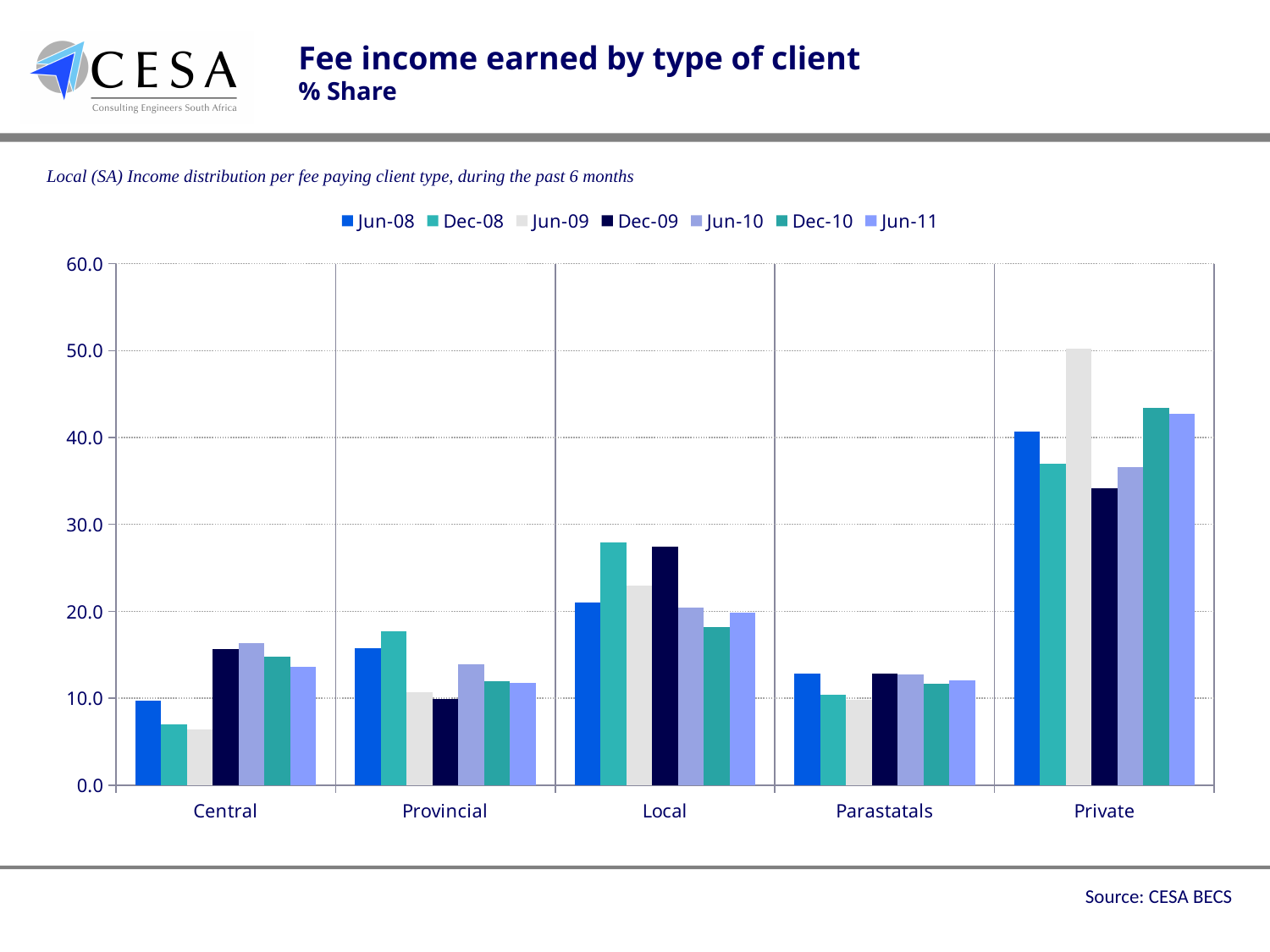
Is the Jun-09 value for Private greater or less than 40.0? greater For Private, which period has the highest share? Jun-09 Is the Dec-08 value for Local greater or less than 20.0? greater Which client type has the lowest Jun-09 share? Central For Local, which is larger: the Jun-08 value or the Dec-08 value? Dec-08 How many series does the legend list? 7 Is the Dec-09 value for Private greater or less than 40.0? less What kind of chart is shown on the slide? bar chart What is the title of the chart? Fee income earned by type of client How many client types are shown on the x axis? 5 Which client type has the highest Jun-09 share? Private